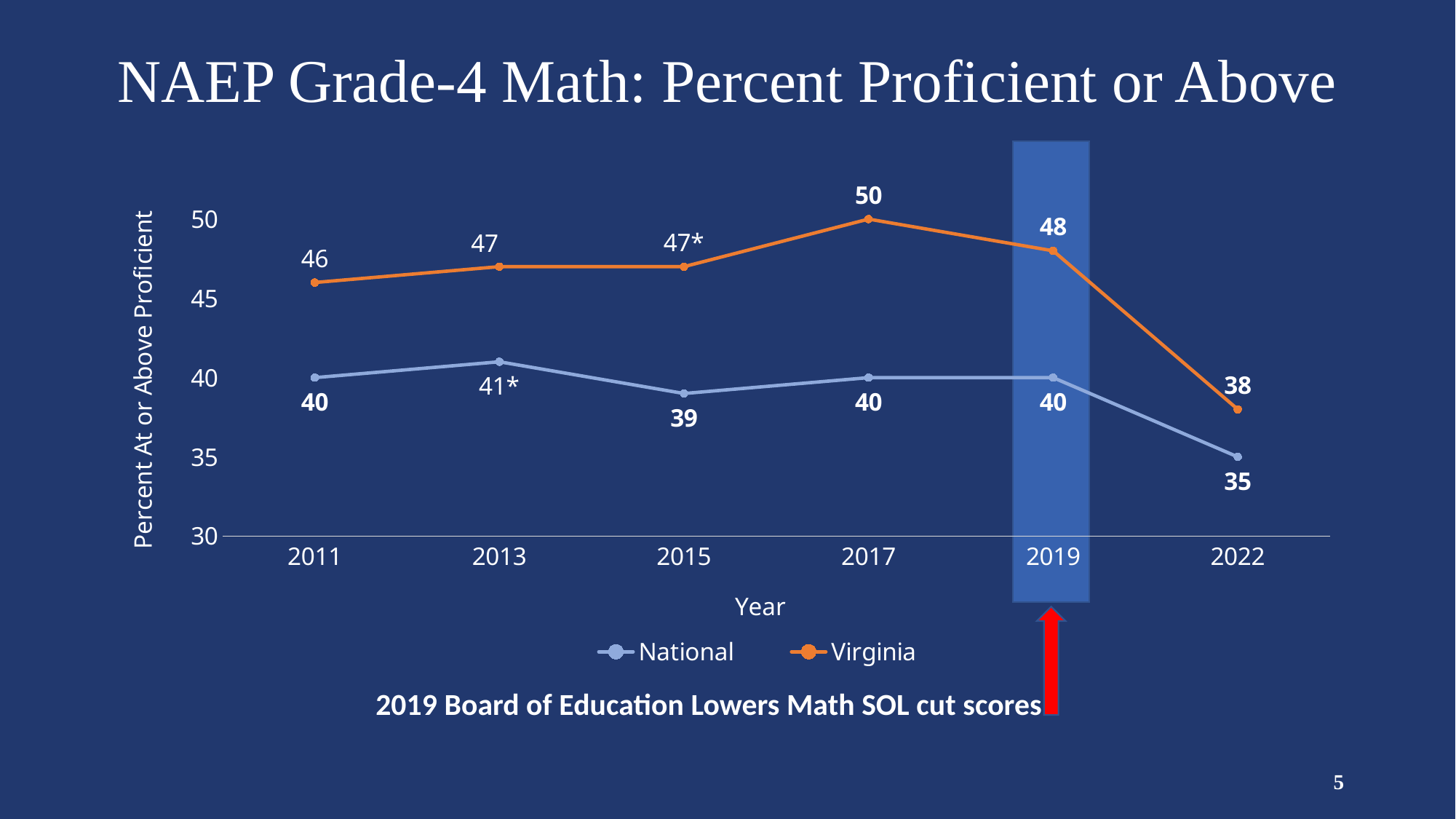
What is the Virginia value for 2011? 46 How many series does the legend list? 2 What kind of chart is shown? Line chart What is the National value for 2022? 35 Does the Virginia series rise or fall from 2019 to 2022? Fall What is the National value for 2015? 39 What is the difference between the Virginia and National values in 2019? 8 What is the Virginia value for 2017? 50 In which year is the National series lowest? 2022 In which year is the Virginia series highest? 2017 How many years are plotted on the x axis? 6 Which is larger in 2022, the Virginia value or the National value? Virginia